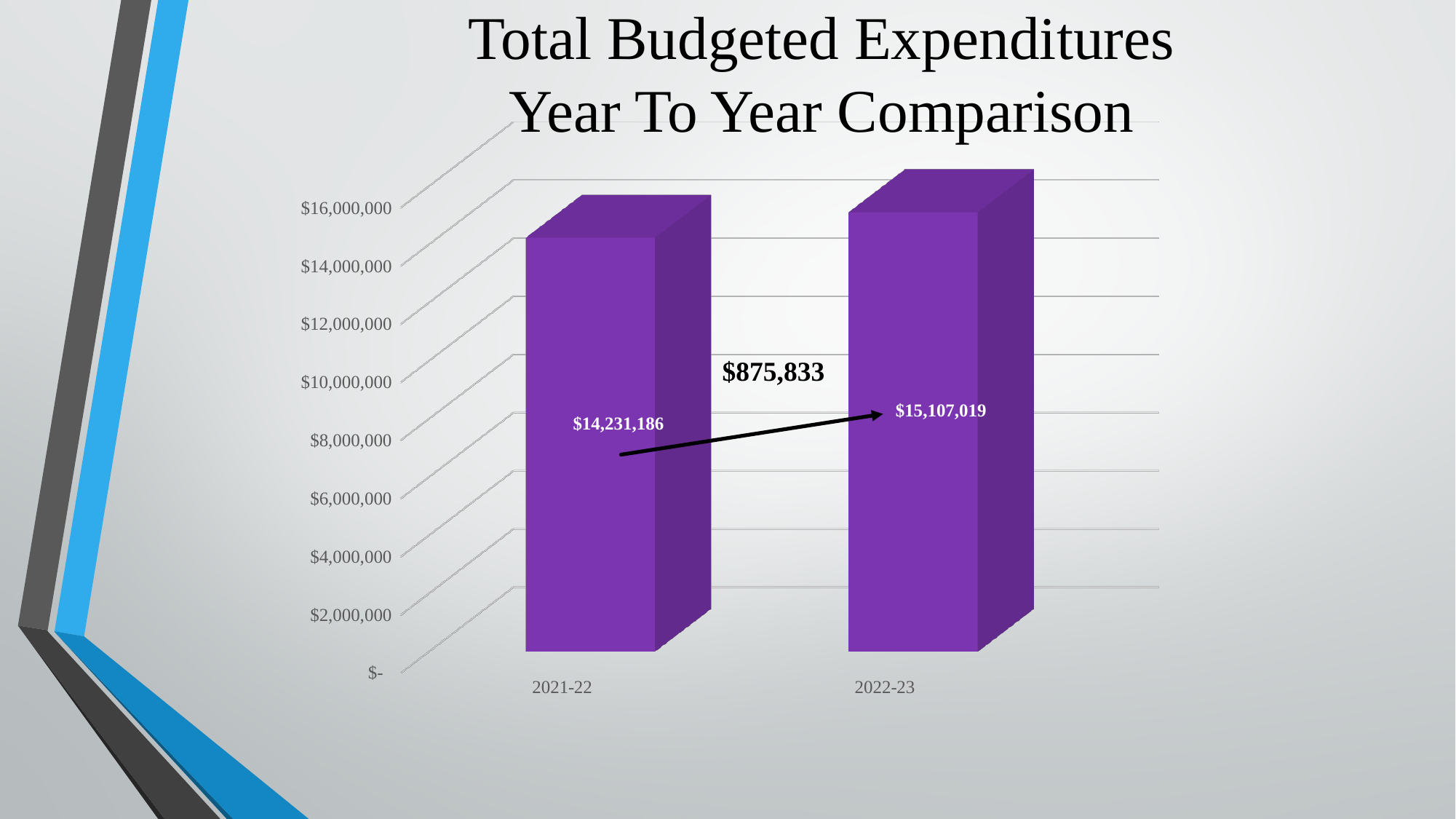
What is the title of the chart? Total Budgeted Expenditures Year To Year Comparison Which year has the lower total budgeted expenditure? 2021-22 What is the total budgeted expenditure for 2021-22? $14,231,186 What is the difference between the 2022-23 and 2021-22 budgeted expenditures? $875,833 Do the budgeted expenditures rise or fall from 2021-22 to 2022-23? rise Is the value for 2022-23 greater or less than $16,000,000? less What is the total budgeted expenditure for 2022-23? $15,107,019 Is the value for 2021-22 greater or less than $14,000,000? greater How many years are shown on the chart? 2 What kind of chart is shown on the slide? bar chart Is the budgeted expenditure for 2022-23 larger or smaller than for 2021-22? larger Which year has the higher total budgeted expenditure? 2022-23